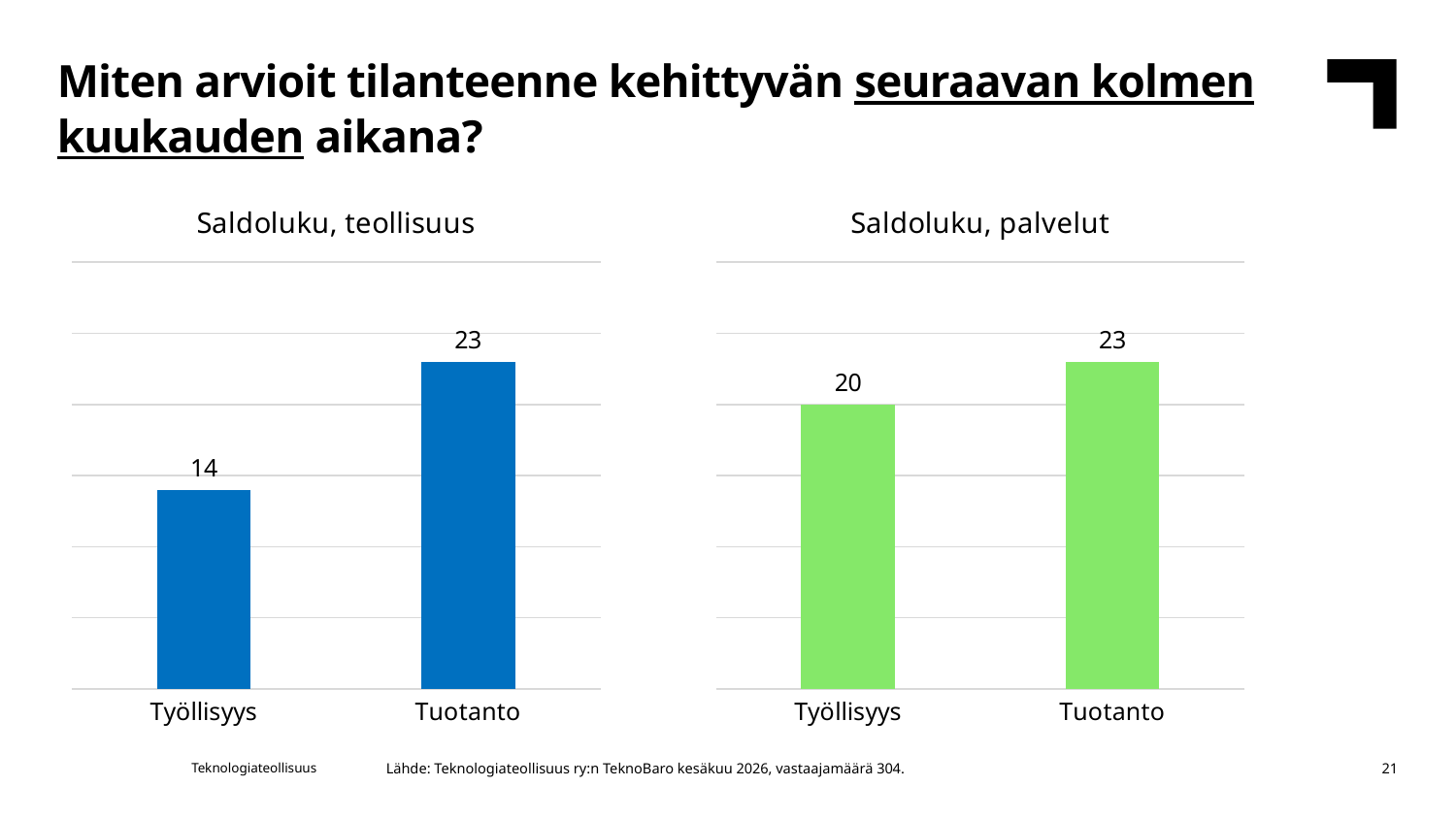
In the 'Saldoluku, teollisuus' chart, what is the value for Tuotanto? 23 How many categories are shown in the 'Saldoluku, teollisuus' chart? 2 Is the value for Työllisyys larger in the 'Saldoluku, teollisuus' chart or in the 'Saldoluku, palvelut' chart? Saldoluku, palvelut In the 'Saldoluku, teollisuus' chart, what is the value for Työllisyys? 14 In the 'Saldoluku, teollisuus' chart, which category has the highest value? Tuotanto In the 'Saldoluku, teollisuus' chart, what is the difference between the values for Tuotanto and Työllisyys? 9 In the 'Saldoluku, palvelut' chart, what is the value for Tuotanto? 23 In the 'Saldoluku, palvelut' chart, which category has the lowest value? Työllisyys What colour are the bars in the 'Saldoluku, teollisuus' chart? Blue What kind of chart is the 'Saldoluku, palvelut' chart? Bar chart In the 'Saldoluku, palvelut' chart, what is the value for Työllisyys? 20 In the 'Saldoluku, palvelut' chart, what is the difference between the values for Tuotanto and Työllisyys? 3